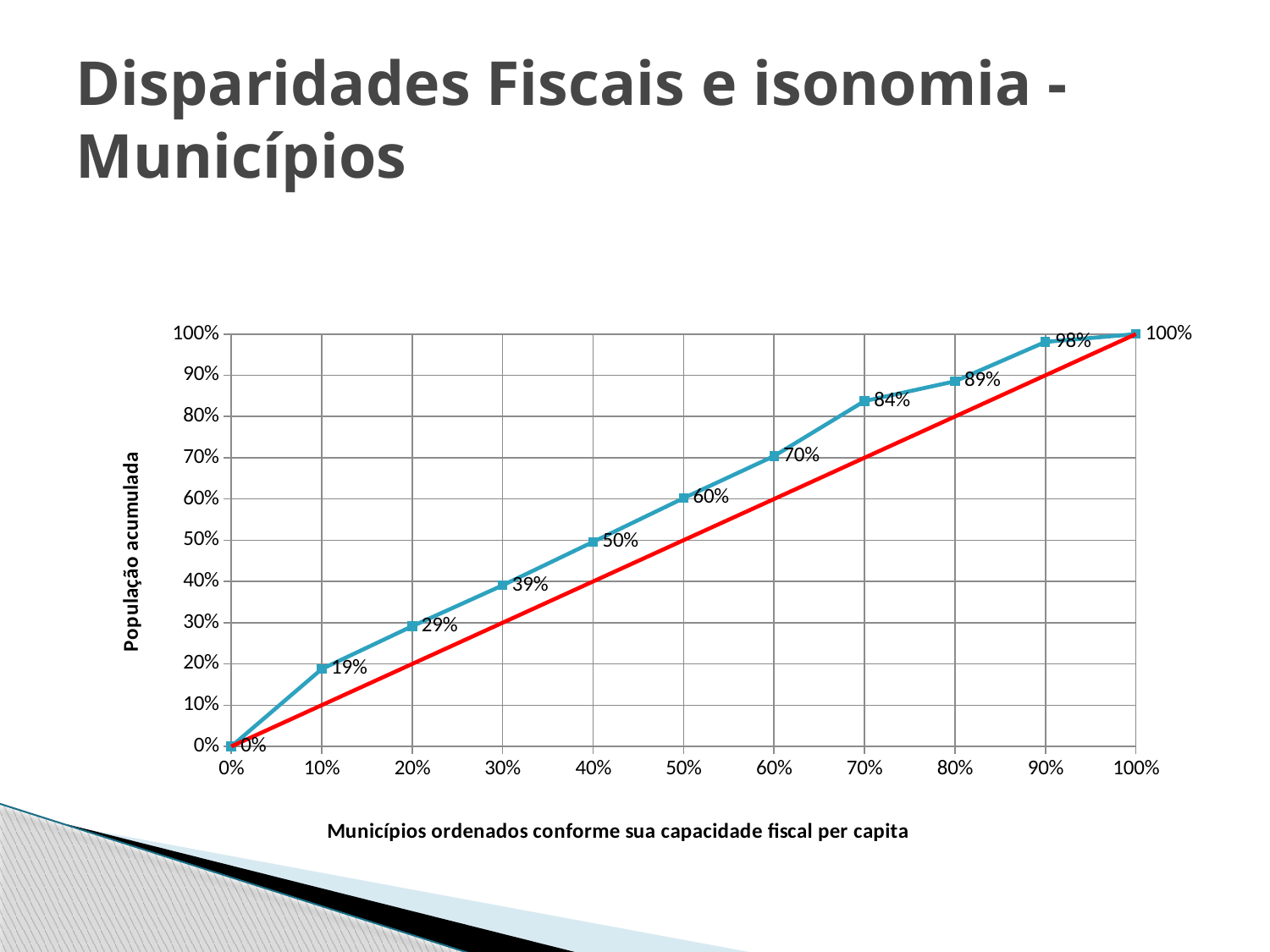
What is the accumulated population value at 90% of municipalities? 98% How many labelled data points are on the blue line? 11 What is the title of the vertical axis? População acumulada What is the difference between the accumulated population values at 30% and 20% of municipalities? 10% What is the title of the horizontal axis? Municípios ordenados conforme sua capacidade fiscal per capita What is the difference between the accumulated population values at 80% and 70% of municipalities? 5% Which is larger, the accumulated population value at 50% or at 60% of municipalities? The value at 60% of municipalities (70%) What is the accumulated population value at 40% of municipalities? 50% What is the accumulated population value at 70% of municipalities? 84% What is the accumulated population value at 10% of municipalities? 19% Do the values on the blue line rise or fall as the x axis increases? Rise What kind of chart is shown on the slide? Line chart